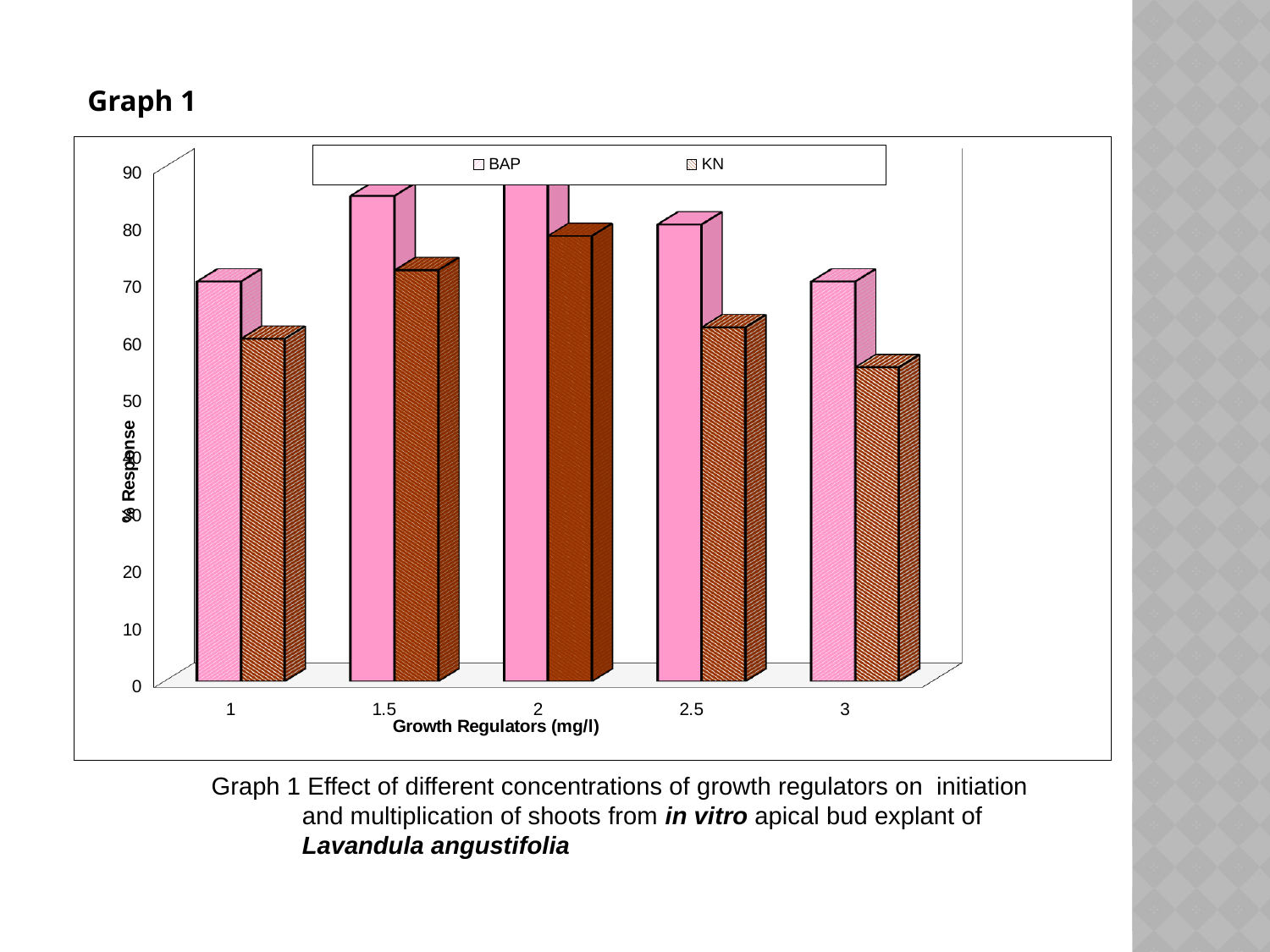
At 2 mg/l, which series has the larger % response, BAP or KN? BAP Is the BAP value at 1.5 mg/l greater or less than 80? greater Do the BAP values rise or fall as the concentration increases from 1 to 2 mg/l? rise Is the KN value at 1 mg/l greater or less than 70? less What is the label of the y axis? % Response Is the KN value at 3 mg/l greater or less than 60? less How many series does the legend list? 2 How many growth regulator concentrations are shown on the x axis? 5 What kind of chart is shown on the slide? bar chart At which concentration is the KN % response lowest? 3 At which concentration is the BAP % response highest? 2